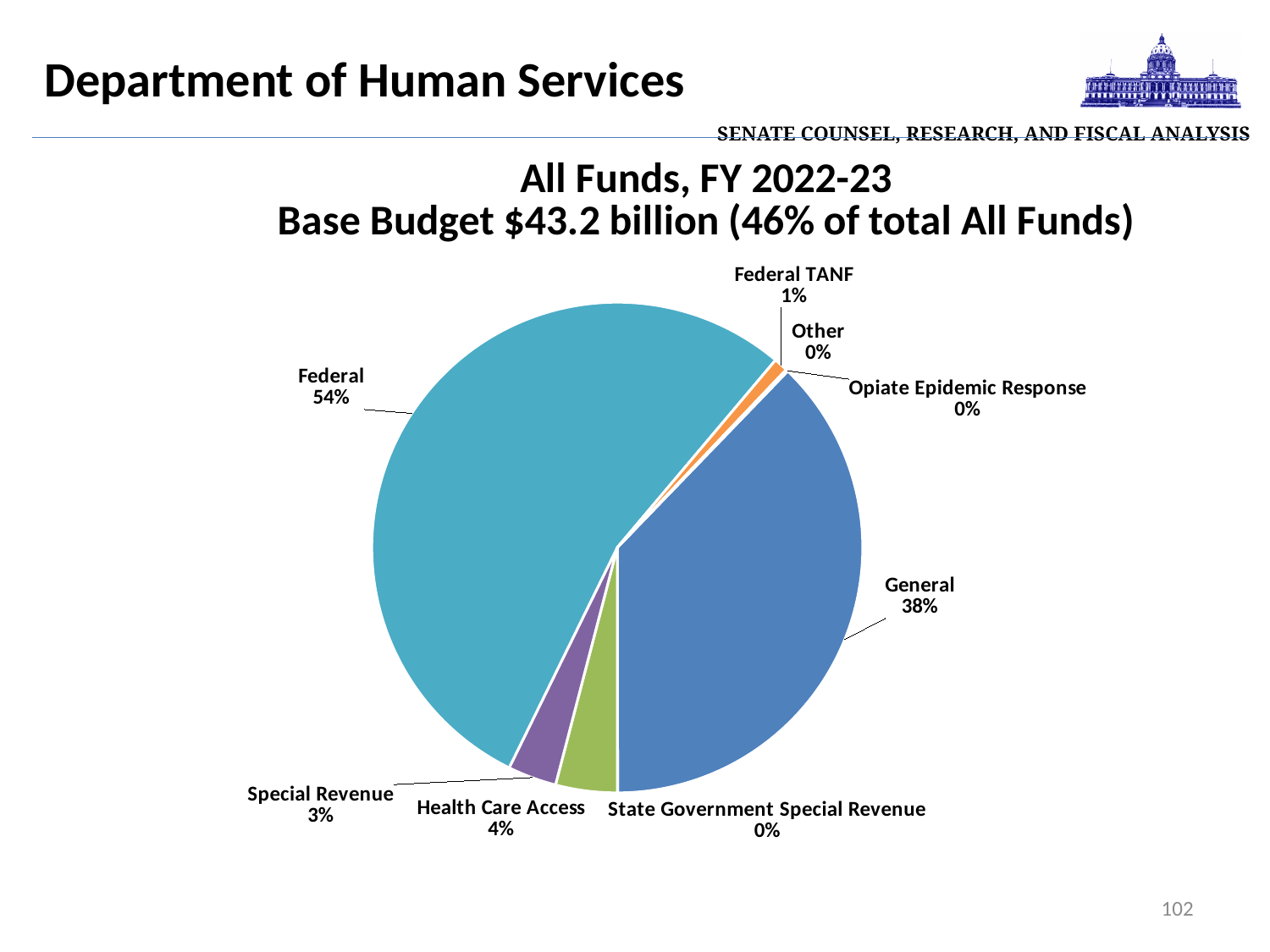
What share of the pie does Federal account for? 54% What is the difference in percentage points between Federal and General? 16 Which category has the largest slice of the pie? Federal What percentage is shown for Health Care Access? 4% What kind of chart is shown on the slide? Pie chart What percentage is shown for State Government Special Revenue? 0% What is the title of the chart? All Funds, FY 2022-23 Base Budget $43.2 billion (46% of total All Funds) Which is larger, Health Care Access or Special Revenue? Health Care Access What percentage is shown for Federal TANF? 1% What share of the pie does General account for? 38% How many categories are labelled on the pie chart? 8 What percentage is shown for Special Revenue? 3%